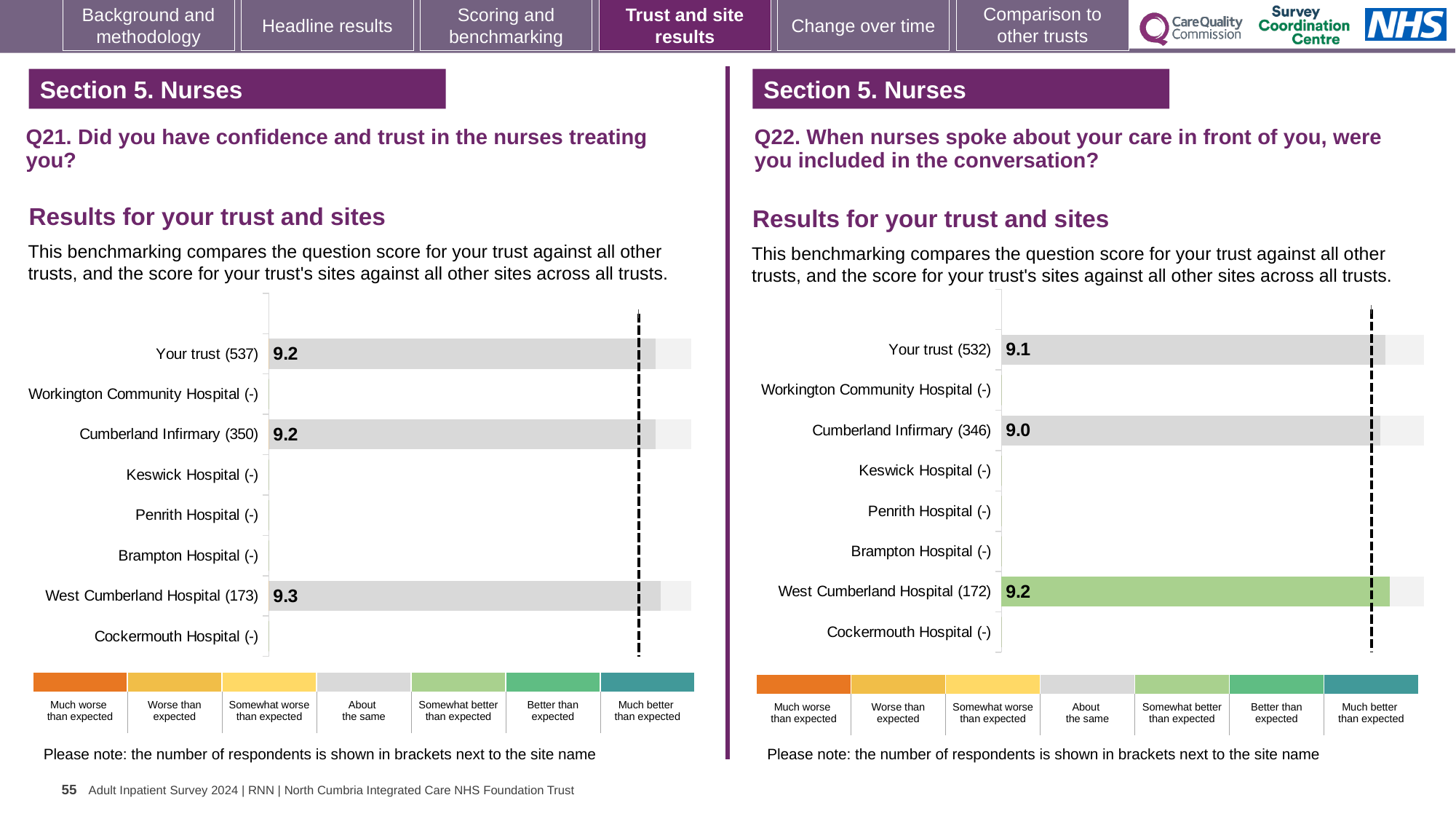
In the Q21 chart on the left, what is the score for Cumberland Infirmary (350)? 9.2 In the Q21 chart on the left, how many site/trust categories are listed on the vertical axis? 8 In the Q22 chart on the right, what is the score for Your trust (532)? 9.1 In the Q22 chart on the right, which bar is coloured green rather than grey? West Cumberland Hospital (172) What type of chart is used for the Q21 results on the left? Bar chart In the Q22 chart on the right, which site has the highest score among those with a plotted value? West Cumberland Hospital (172) In the Q22 chart on the right, what is the score for West Cumberland Hospital (172)? 9.2 In the Q22 chart on the right, which site has the lowest score among those with a plotted value? Cumberland Infirmary (346) In the Q21 chart on the left, what is the score for Your trust (537)? 9.2 In the Q22 chart on the right, what is the difference between the scores for West Cumberland Hospital (172) and Cumberland Infirmary (346)? 0.2 In the Q21 chart on the left, what is the score for West Cumberland Hospital (173)? 9.3 In the Q22 chart on the right, what is the score for Cumberland Infirmary (346)? 9.0